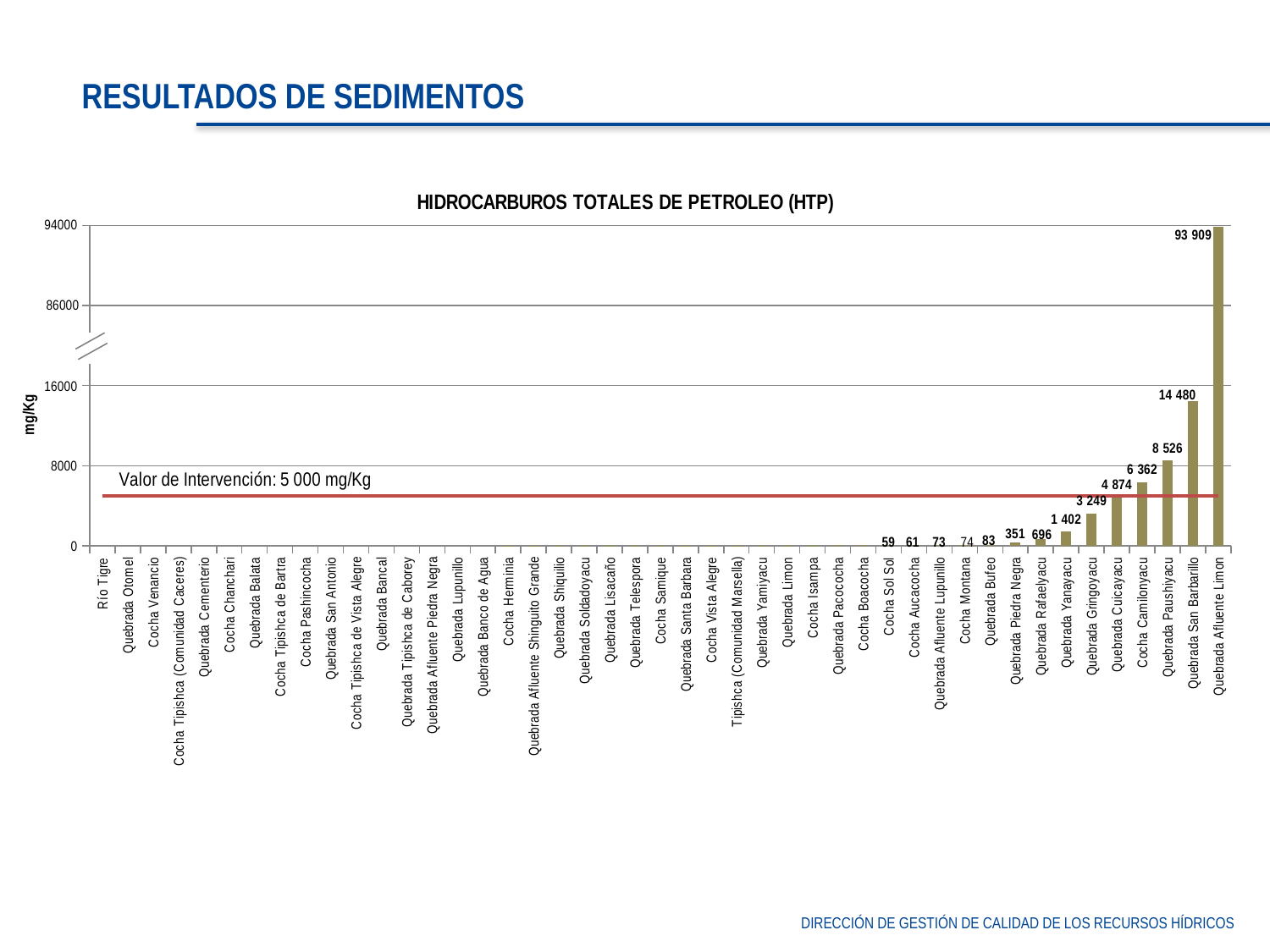
Which has a higher HTP value, Quebrada Rafaelyacu or Quebrada Yanayacu? Quebrada Yanayacu Is the HTP value for Quebrada Cuicayacu greater or less than 8000? less What is the HTP value for Quebrada Afluente Limon? 93 909 What type of chart is shown on the slide? Bar chart What is the difference in HTP between Cocha Camilonyacu and Quebrada Cuicayacu? 1 488 What is the HTP value for Quebrada Paushiyacu? 8 526 What intervention value (Valor de Intervención) is marked by the red line on the chart? 5 000 mg/Kg Which site has the highest HTP value? Quebrada Afluente Limon What is the difference in HTP between Quebrada Afluente Limon and Quebrada San Barbarillo? 79 429 What is the HTP value for Quebrada Gringoyacu? 3 249 What is the HTP value for Quebrada San Barbarillo? 14 480 What is the HTP value for Quebrada Piedra Negra? 351